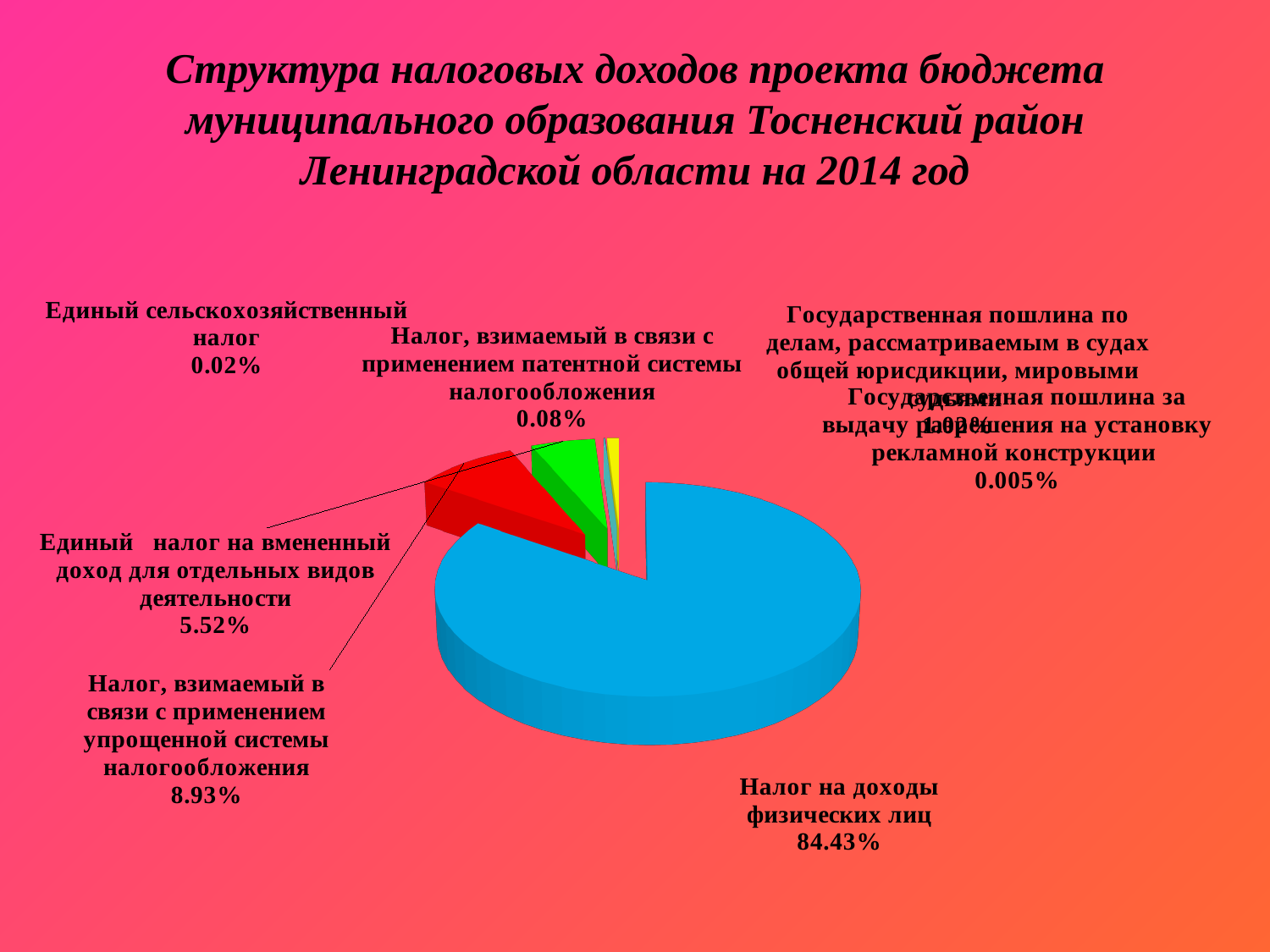
Which category has the smallest share of the pie? Государственная пошлина за выдачу разрешения на установку рекламной конструкции Which is larger: the share for "Единый сельскохозяйственный налог" or the share for "Налог, взимаемый в связи с применением патентной системы налогообложения"? Налог, взимаемый в связи с применением патентной системы налогообложения What share of tax revenues does "Налог на доходы физических лиц" account for? 84.43% How many categories (slices) are labelled on the pie chart? 7 What is the difference in percentage points between "Налог, взимаемый в связи с применением упрощенной системы налогообложения" and "Единый налог на вмененный доход для отдельных видов деятельности"? 3.41 What is the value shown for "Единый налог на вмененный доход для отдельных видов деятельности"? 5.52% What is the value shown for "Налог, взимаемый в связи с применением упрощенной системы налогообложения"? 8.93% What is the value shown for "Налог, взимаемый в связи с применением патентной системы налогообложения"? 0.08% What is the value shown for "Единый сельскохозяйственный налог"? 0.02% What kind of chart is shown on the slide? pie chart What is the value shown for "Государственная пошлина за выдачу разрешения на установку рекламной конструкции"? 0.005% Which category has the largest share of the pie? Налог на доходы физических лиц